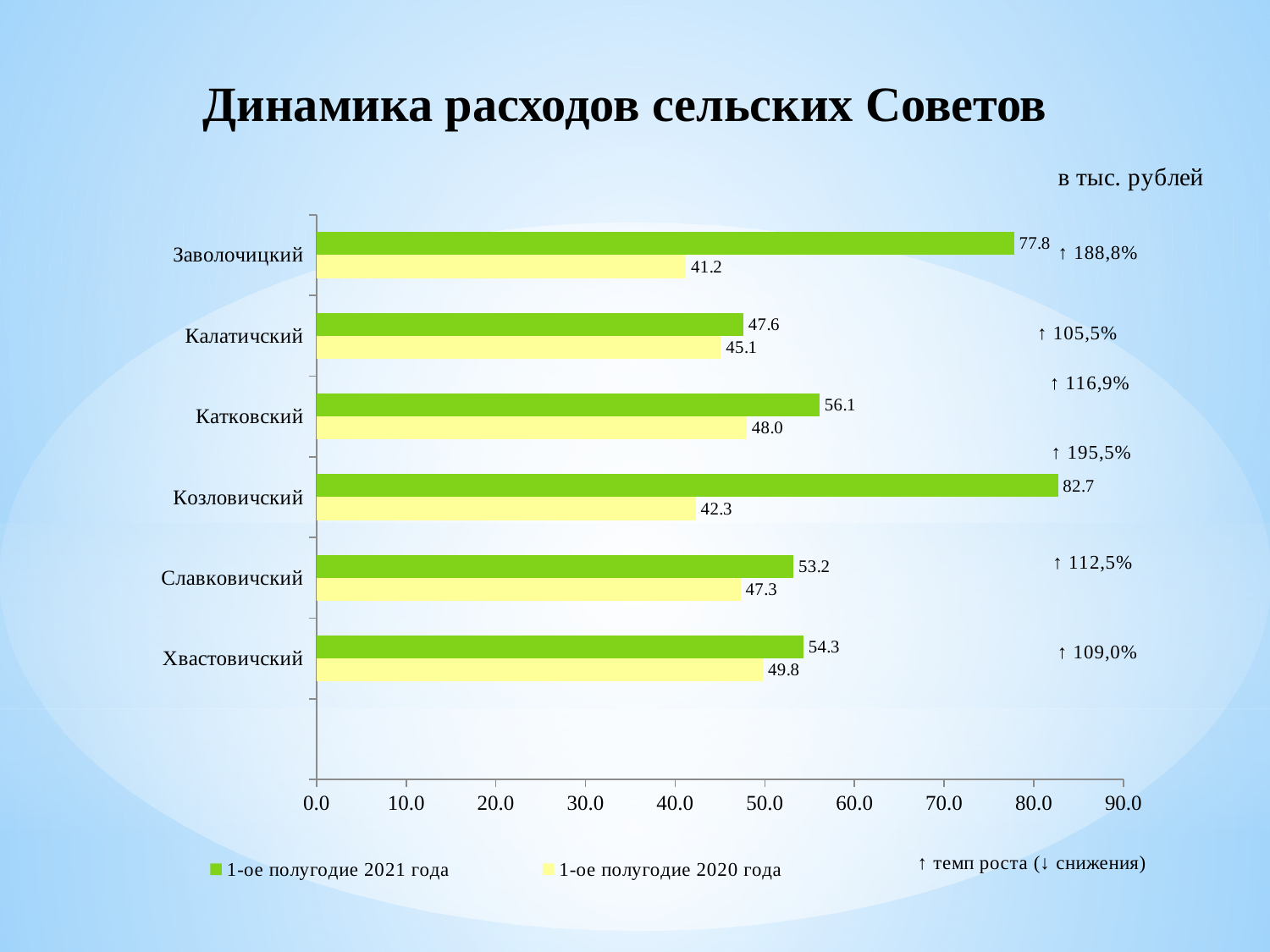
What is the difference between the 2021 and 2020 values for Козловичский? 40.4 What is the value for Хвастовичский in the series 1-ое полугодие 2020 года? 49.8 Which is larger: the 2021 value for Славковичский or the 2021 value for Хвастовичский? Хвастовичский What is the value for Катковский in the series 1-ое полугодие 2020 года? 48.0 What kind of chart is shown on the slide? bar chart Is the value for Калатичский in the series 1-ое полугодие 2021 года greater or less than 50.0? less What is the value for Заволочицкий in the series 1-ое полугодие 2021 года? 77.8 Which category has the lowest value in the series 1-ое полугодие 2020 года? Заволочицкий How many series does the legend list? 2 What growth rate (темп роста) is shown next to Козловичский? ↑ 195,5% How many categories (сельские Советы) are shown on the chart? 6 Which category has the highest value in the series 1-ое полугодие 2021 года? Козловичский